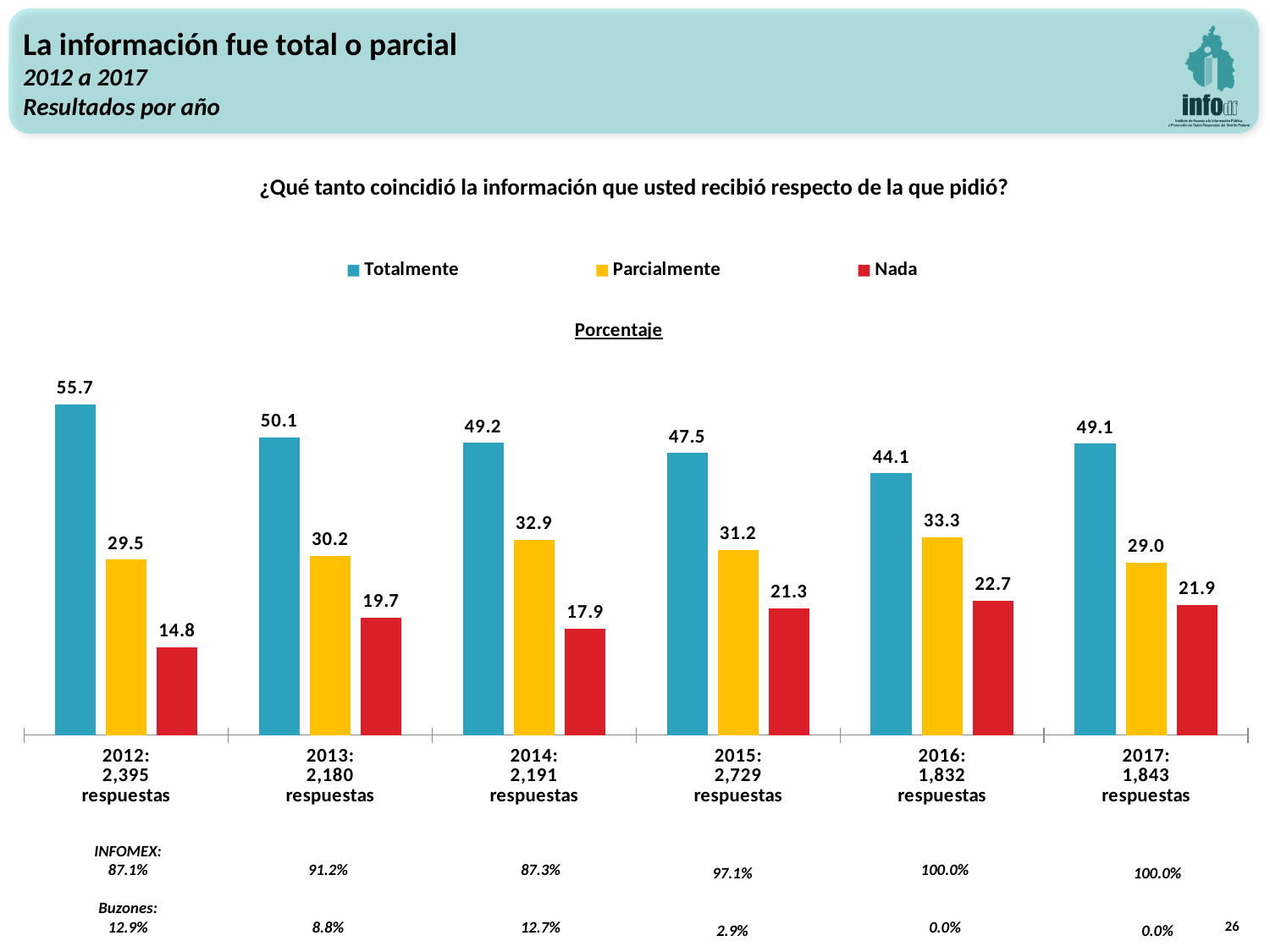
What kind of chart is shown? bar chart Which is larger, the Parcialmente value in 2014 or in 2015? 2014 In which year is the Nada value lowest? 2012 In which year is the Totalmente value highest? 2012 What is the difference between the Totalmente values for 2012 and 2017? 6.6 How many series does the legend list? 3 How many respuestas are listed for 2015? 2,729 How many years are shown on the x axis? 6 What is the value for Nada in 2014? 17.9 Does the Totalmente value rise or fall from 2012 to 2016? fall What is the value for Parcialmente in 2016? 33.3 What is the value for Totalmente in 2012? 55.7